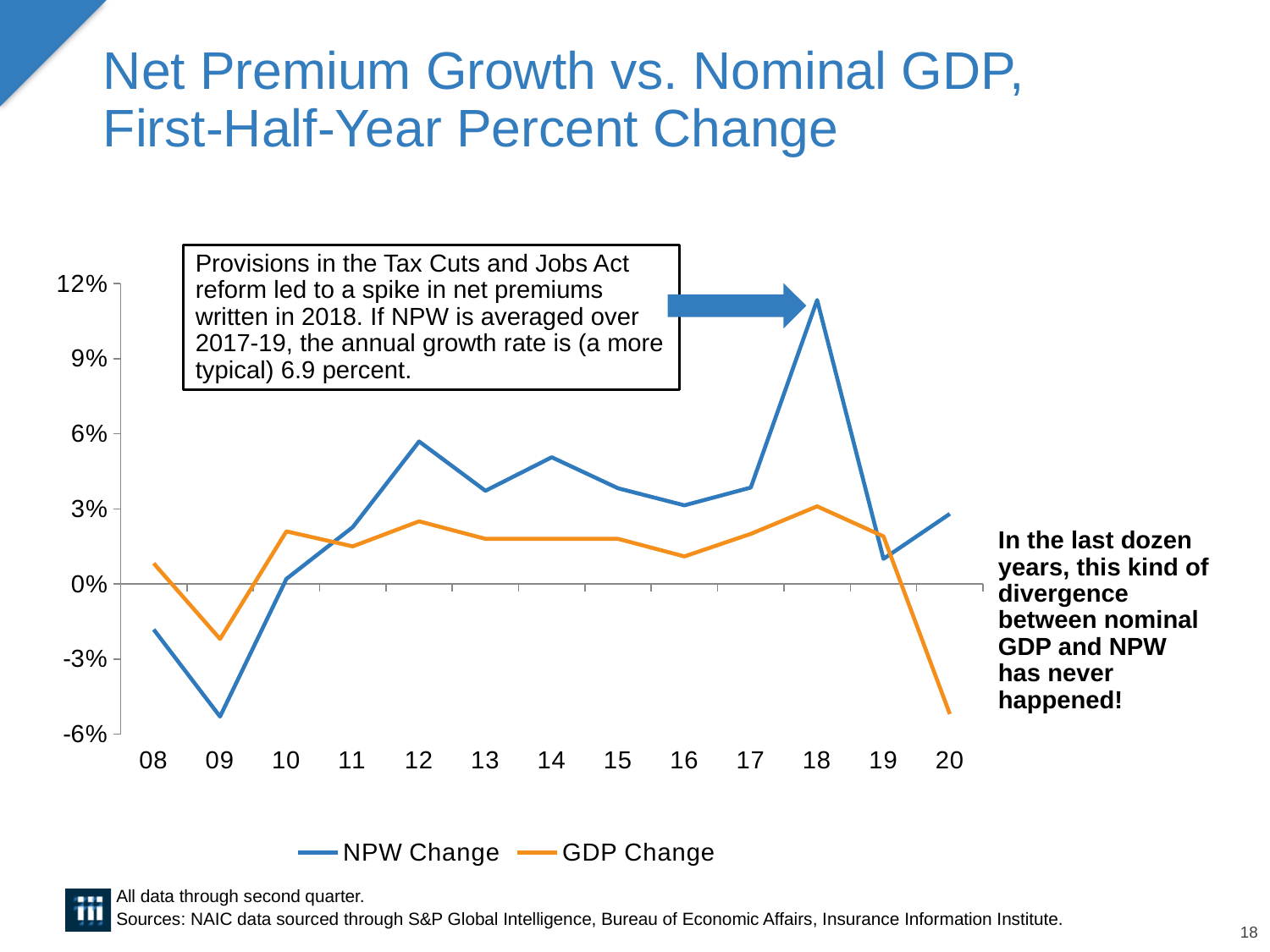
Is the NPW Change value for 09 greater or less than -3%? less Does NPW Change rise or fall from 18 to 19? fall In which year does GDP Change reach its lowest value? 20 Is the GDP Change value for 20 greater or less than -3%? less What kind of chart is shown on the slide? line chart In which year does NPW Change reach its lowest value? 09 In 18, which series has the larger value, NPW Change or GDP Change? NPW Change How many series does the legend list? 2 How many years are plotted along the x axis? 13 In which year does NPW Change reach its highest value? 18 Is the NPW Change value for 18 greater or less than 9%? greater In which year does GDP Change reach its highest value? 18